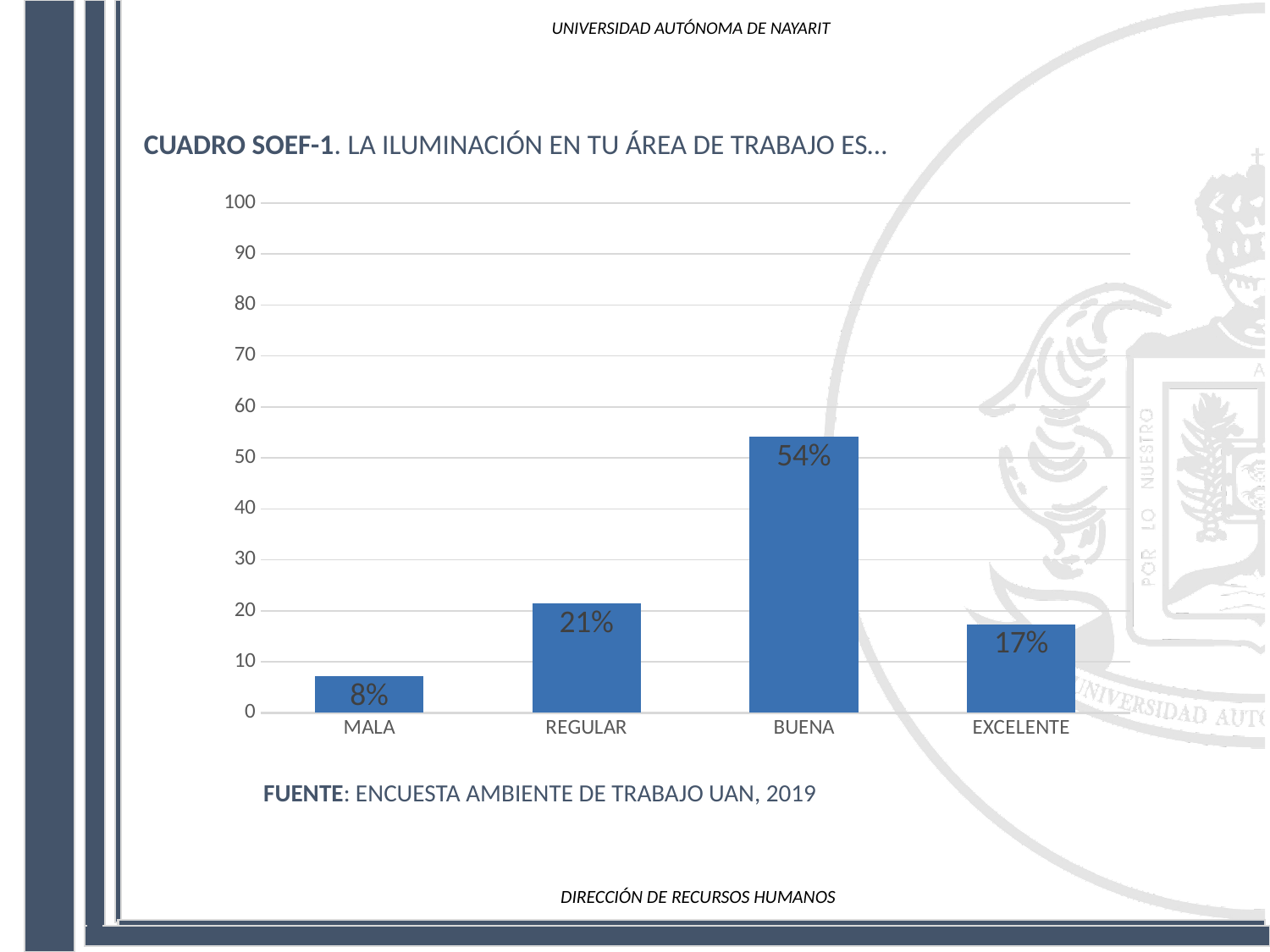
Which category has the lowest value? MALA How many categories are shown on the x axis? 4 Which category has the highest value? BUENA Which is larger, the value for REGULAR or the value for EXCELENTE? REGULAR What is the value for EXCELENTE? 17% Is the value for BUENA greater or less than 50? greater What source is cited below the chart? ENCUESTA AMBIENTE DE TRABAJO UAN, 2019 What is the value for BUENA? 54% What is the value for MALA? 8% What is the value for REGULAR? 21% What is the difference between the values for BUENA and REGULAR? 33% What kind of chart is shown on the slide? bar chart